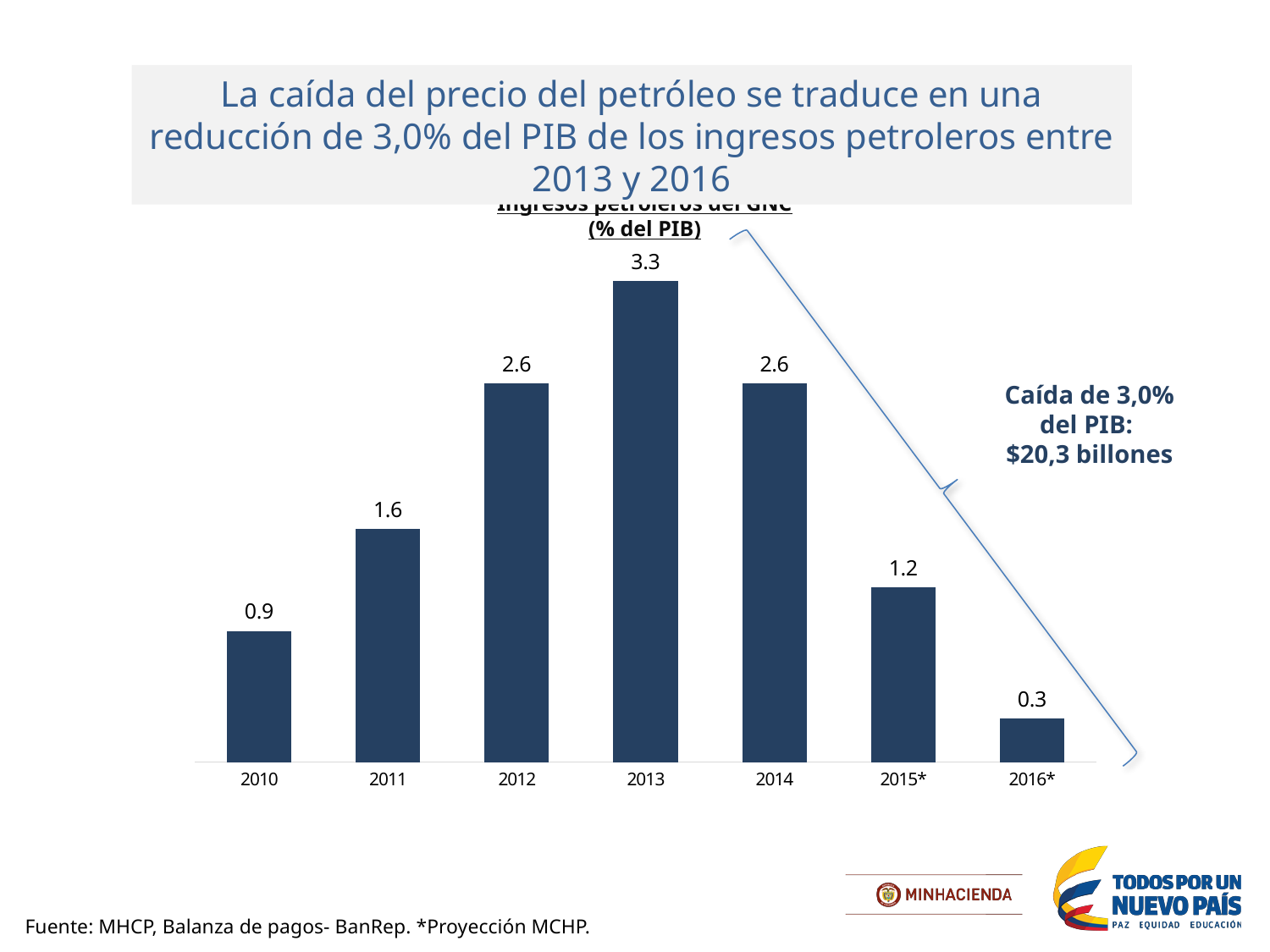
What is the value for 2015*? 1.2 Which is larger, the value for 2011 or the value for 2015*? 2011 Which year has the lowest value? 2016* Do the values rise or fall from 2013 to 2016*? Fall What kind of chart is shown on the slide? Bar chart What is the difference between the values for 2013 and 2016*? 3.0 What is the value for 2013? 3.3 What is the difference between the values for 2011 and 2010? 0.7 How many bars are shown in the chart? 7 Which year has the highest value? 2013 What is the value for 2010? 0.9 What is the value for 2016*? 0.3